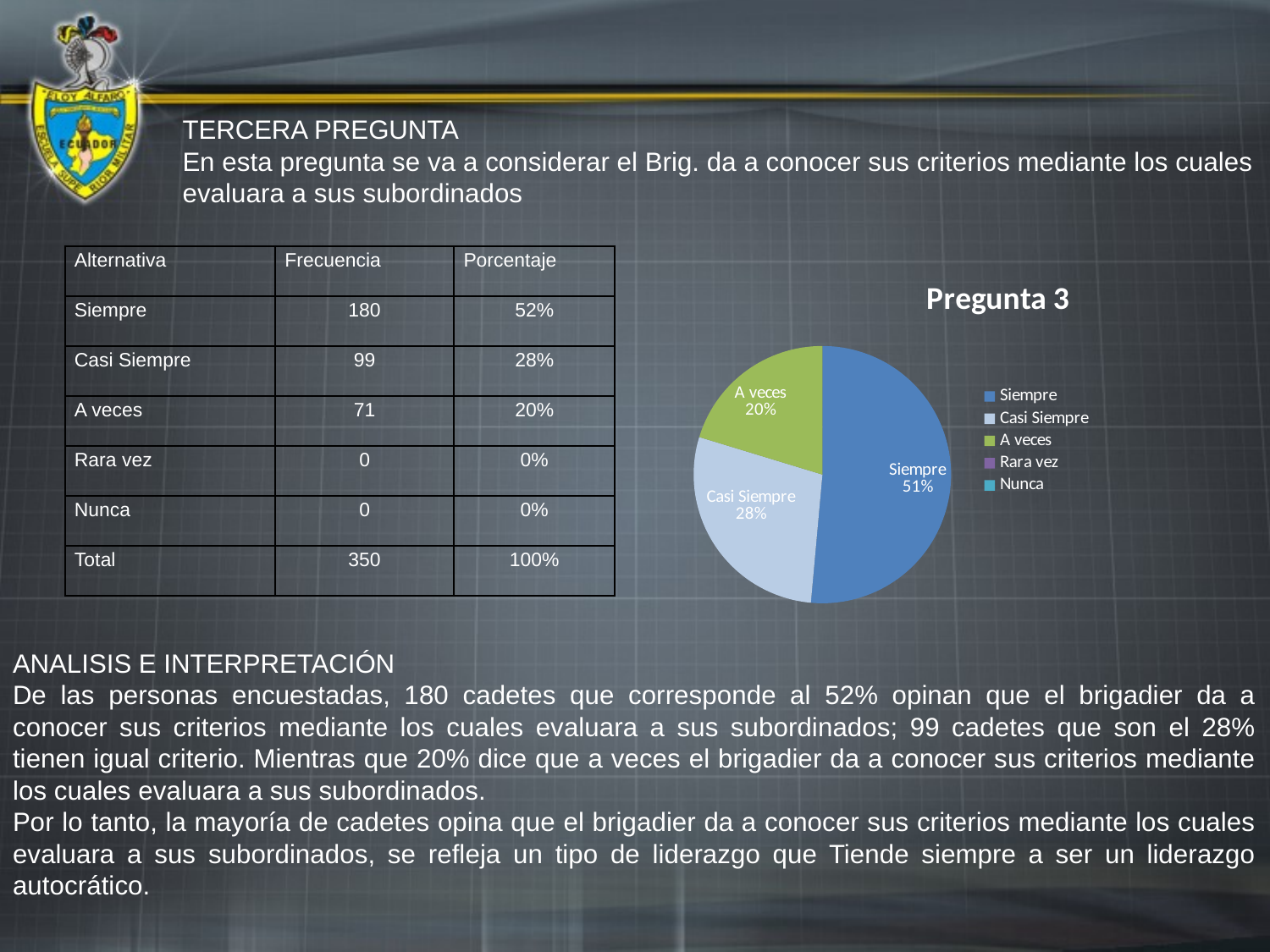
In the pie chart, what percentage is shown for the Siempre slice? 51% In the pie chart, which slice is larger: Casi Siempre or A veces? Casi Siempre In the pie chart, what is the difference in percentage points between the Casi Siempre slice and the A veces slice? 8 In the pie chart, what percentage is shown for the A veces slice? 20% Which slice of the pie chart is the largest? Siempre Which legend entries of the pie chart have no visible slice? Rara vez and Nunca In the pie chart, what is the difference in percentage points between the Siempre slice and the Casi Siempre slice? 23 In the pie chart, what percentage is shown for the Casi Siempre slice? 28% How many entries does the pie chart's legend list? 5 Of the labelled slices in the pie chart, which is the smallest? A veces What is the title of the pie chart? Pregunta 3 What type of chart is shown on the slide? Pie chart